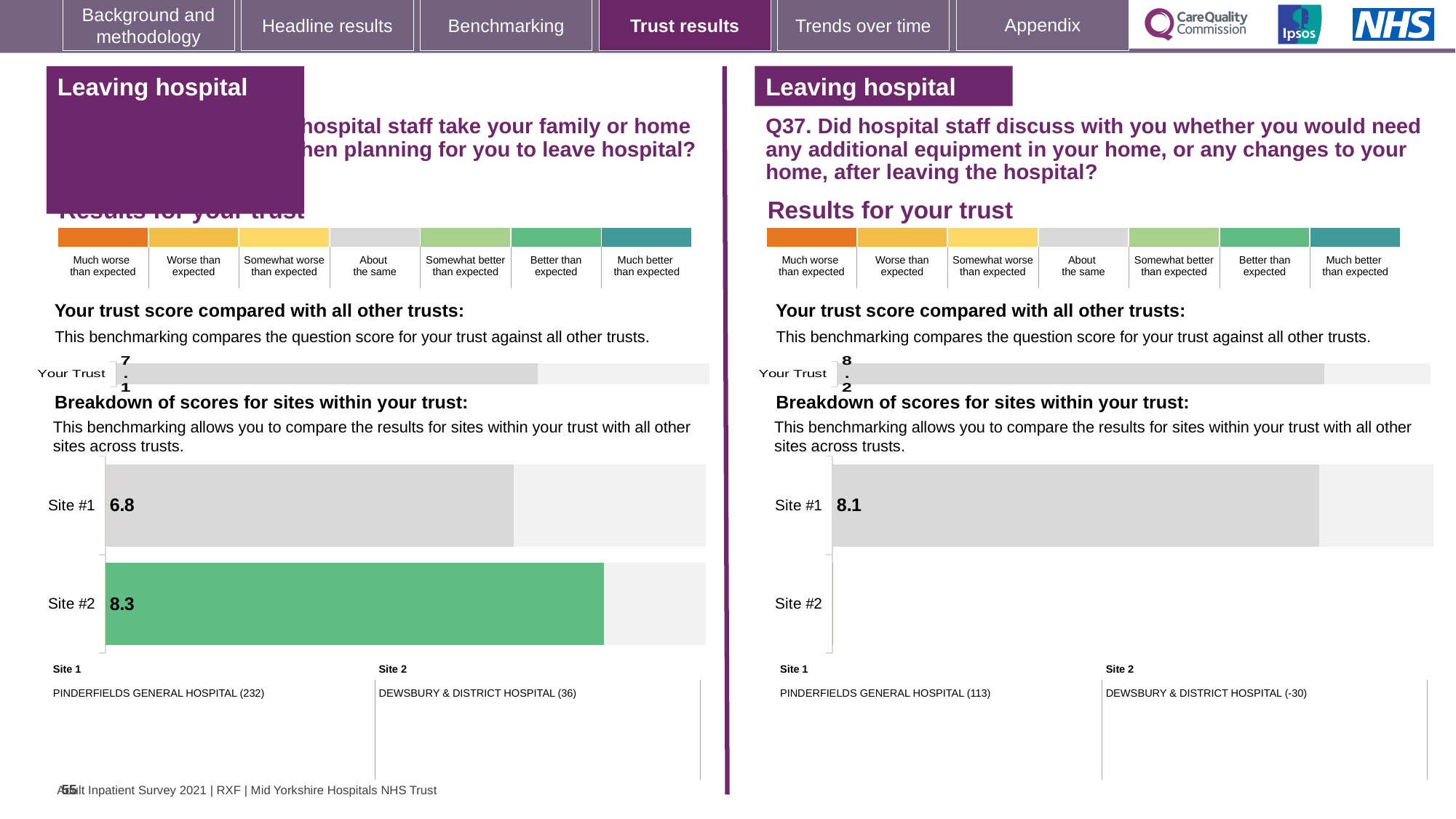
In the left-hand site breakdown chart, what colour is the bar for Site #2? Green In the right-hand (Q37) site breakdown chart, what is the score for Site #1? 8.1 Which is larger: the Your Trust score in the left-hand chart or the Your Trust score in the right-hand (Q37) chart? The right-hand (Q37) chart In the left-hand site breakdown chart, which site has the higher score, Site #1 or Site #2? Site #2 In the right-hand (Q37) site breakdown chart, which site has no bar or score displayed? Site #2 In the left-hand 'Your trust score compared with all other trusts' chart, what is the score shown for Your Trust? 7.1 What kind of chart is used for the site breakdown on the left-hand side of the slide? Bar chart In the left-hand 'Breakdown of scores for sites within your trust' chart, what is the score for Site #1? 6.8 How many sites are listed in the right-hand (Q37) site breakdown chart? 2 In the left-hand site breakdown chart, what is the difference between the Site #2 score and the Site #1 score? 1.5 In the right-hand (Q37) 'Your trust score compared with all other trusts' chart, what is the score shown for Your Trust? 8.2 In the left-hand 'Breakdown of scores for sites within your trust' chart, what is the score for Site #2? 8.3